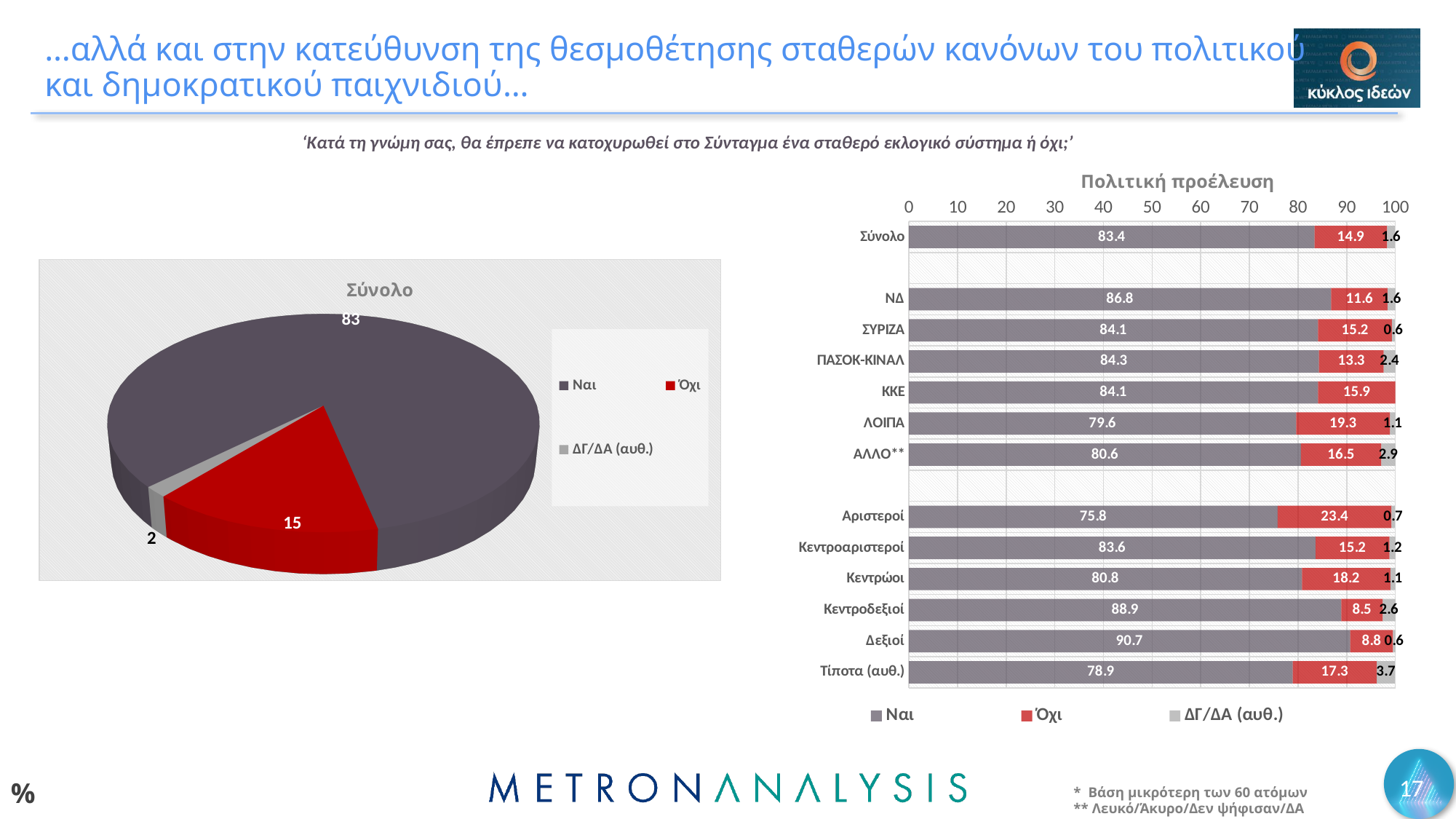
In the chart titled Πολιτική προέλευση, which category has the lowest Ναι value? Αριστεροί How many series does the legend of the chart titled Πολιτική προέλευση list? 3 In the pie chart titled Σύνολο, which slice is the smallest? ΔΓ/ΔΑ (αυθ.) What kind of chart is the chart on the left of the slide? Pie chart In the chart titled Πολιτική προέλευση, what is the Ναι value for ΝΔ? 86.8 In the chart titled Πολιτική προέλευση, what is the difference between the Ναι values for Δεξιοί and Αριστεροί? 14.9 In the chart titled Πολιτική προέλευση, which category has the highest Ναι value? Δεξιοί In the pie chart titled Σύνολο, what value is shown for Ναι? 83 In the pie chart titled Σύνολο, what value is shown for Όχι? 15 What kind of chart is the chart titled Πολιτική προέλευση? Bar chart In the chart titled Πολιτική προέλευση, which has the larger Όχι value, ΛΟΙΠΑ or ΠΑΣΟΚ-ΚΙΝΑΛ? ΛΟΙΠΑ In the chart titled Πολιτική προέλευση, what is the Όχι value for Αριστεροί? 23.4